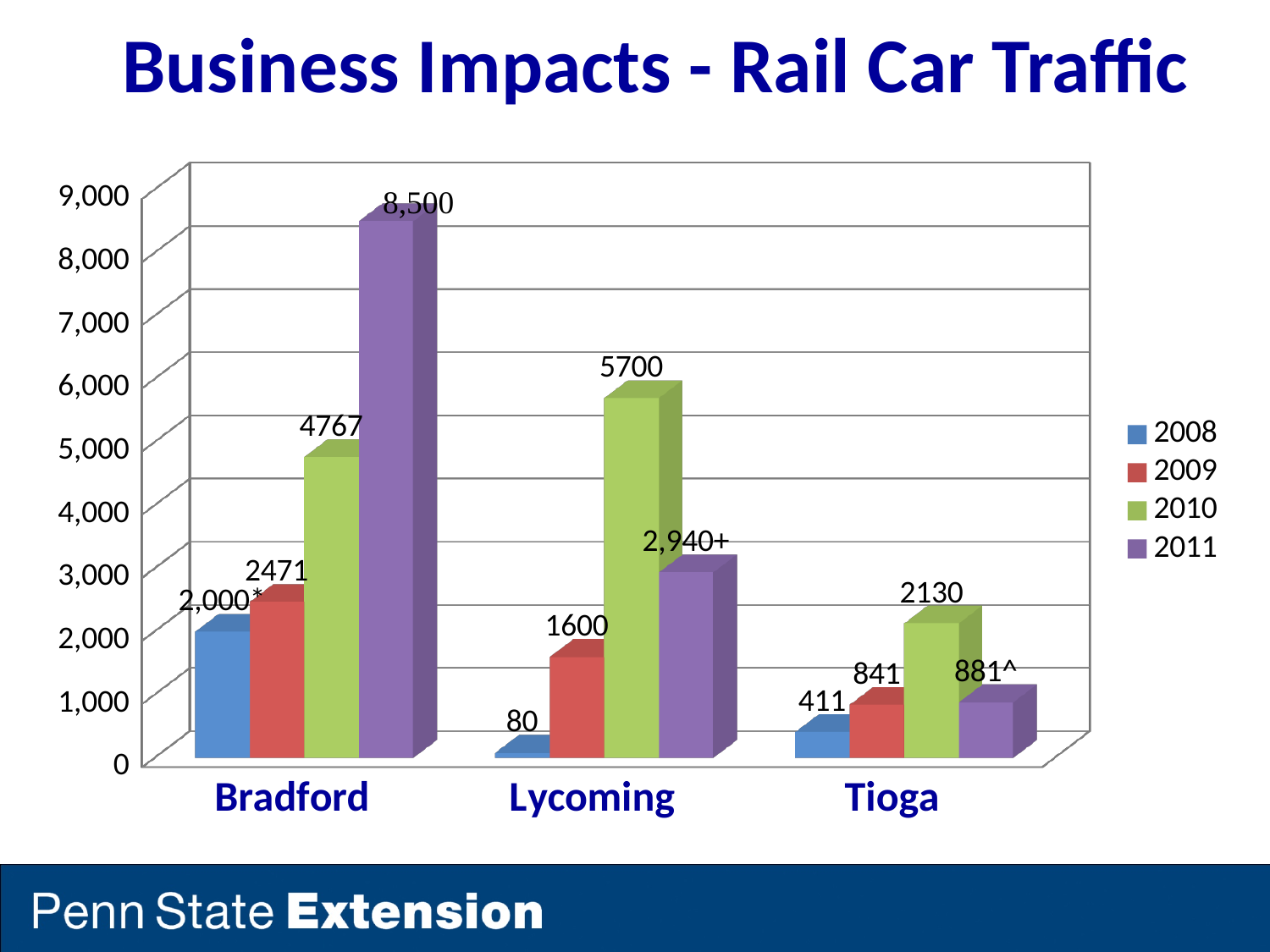
What is the value for Lycoming in 2010? 5700 How many counties are shown on the x axis? 3 What is the value for Lycoming in 2008? 80 What is the value for Tioga in 2008? 411 What is the difference between the 2010 and 2009 values for Bradford? 2296 What is the value for Bradford in 2011? 8,500 Which is larger, the 2010 value for Bradford or the 2010 value for Lycoming? Lycoming Which county has the lowest value in 2010? Tioga Which county has the highest value in 2011? Bradford What is the difference between the 2010 and 2009 values for Lycoming? 4100 What kind of chart is shown on the slide? Bar chart How many series does the legend list? 4